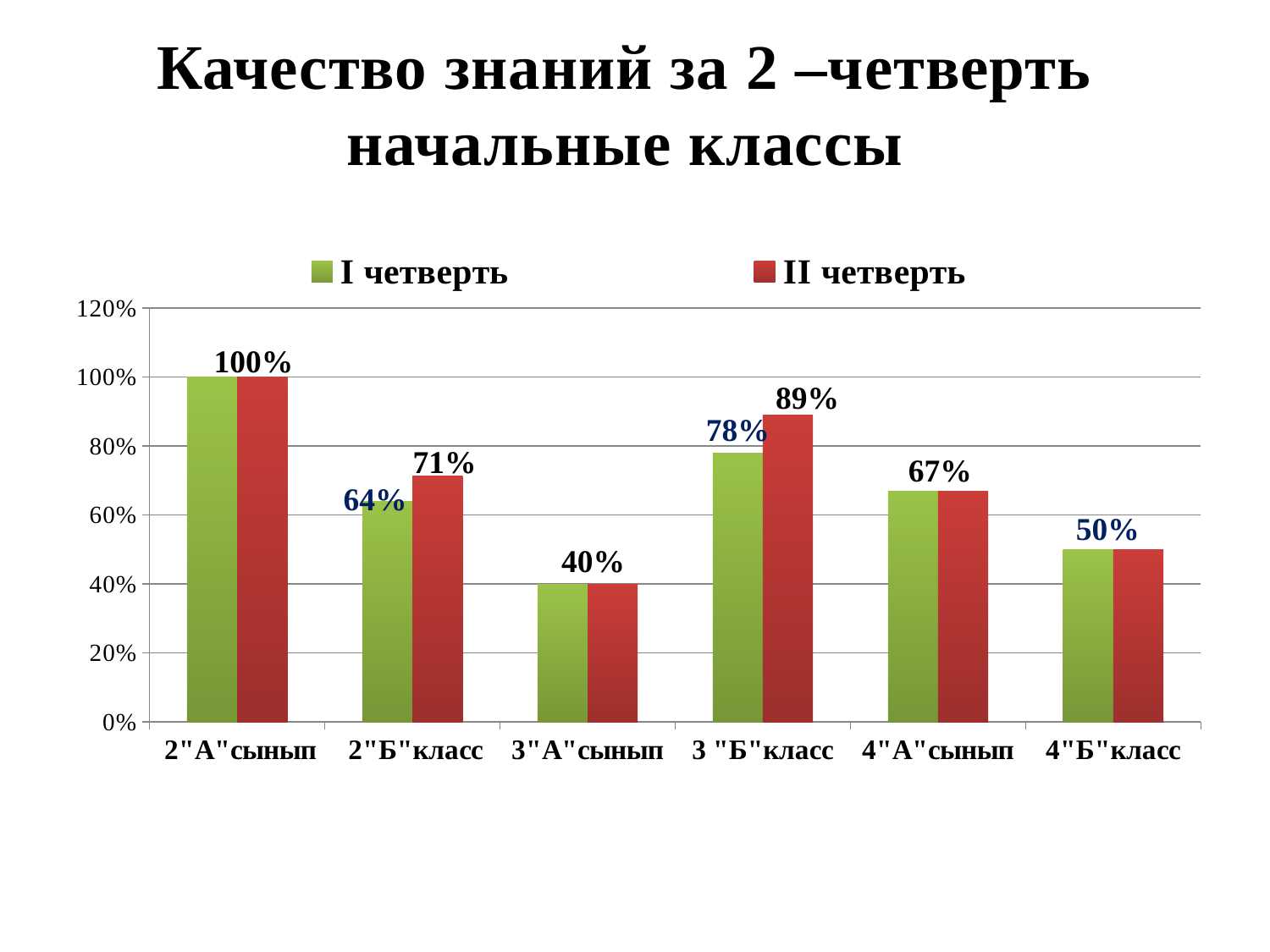
Is the value for 4"А"сынып in II четверть greater or less than 60%? greater How many series does the legend list? 2 Which colour represents II четверть in the legend? red What type of chart is shown on the slide? bar chart What is the value for 4"Б"класс in I четверть? 50% Which class has the lowest value in I четверть? 3"А"сынып Which class has the highest value in II четверть? 2"А"сынып What is the value for 2"Б"класс in II четверть? 71% Which is larger for 2"Б"класс: the I четверть value or the II четверть value? II четверть What is the difference between the II четверть and I четверть values for 3 "Б"класс? 11% How many classes (categories) are shown on the x axis? 6 What is the value for 3 "Б"класс in I четверть? 78%